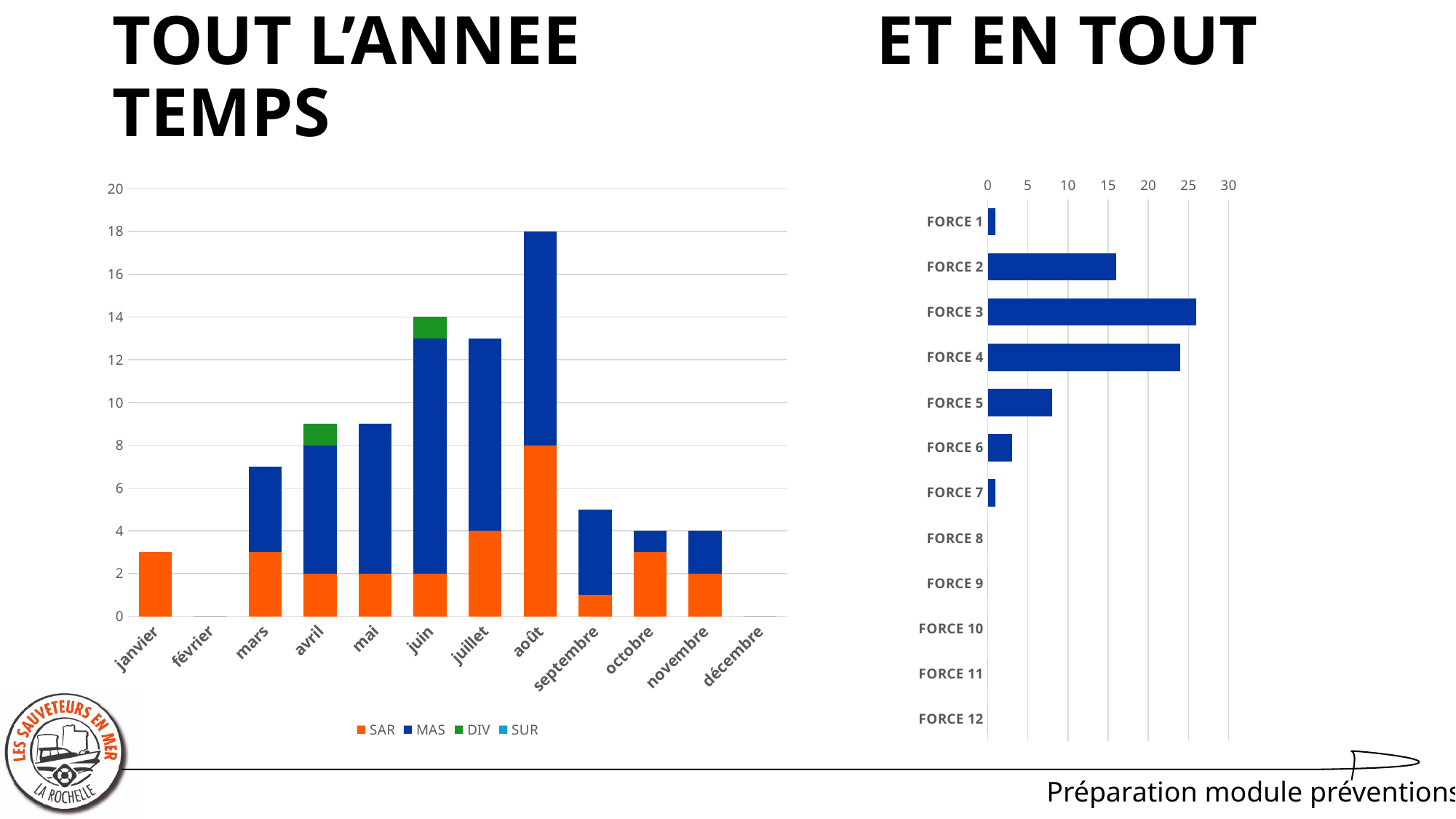
On the right chart, is the value for FORCE 2 greater or less than 15? greater What kind of chart is the right chart (ET EN TOUT)? Bar chart On the left chart, how many series does the legend list? 4 On the left chart, what is the SAR value for juillet? 4 On the right chart (ET EN TOUT), which force has the longest bar? FORCE 3 On the left chart, what is the total height of the stacked bar for août? 18 On the left chart, which colour represents the MAS series? Blue On the left chart, how many months are shown on the x axis? 12 On the left chart (TOUT L'ANNEE TEMPS), which month has the tallest stacked bar? août On the left chart, is the total for juillet greater or less than 12? greater On the left chart, what is the SAR value for août? 8 On the left chart, what is the total height of the stacked bar for juin? 14